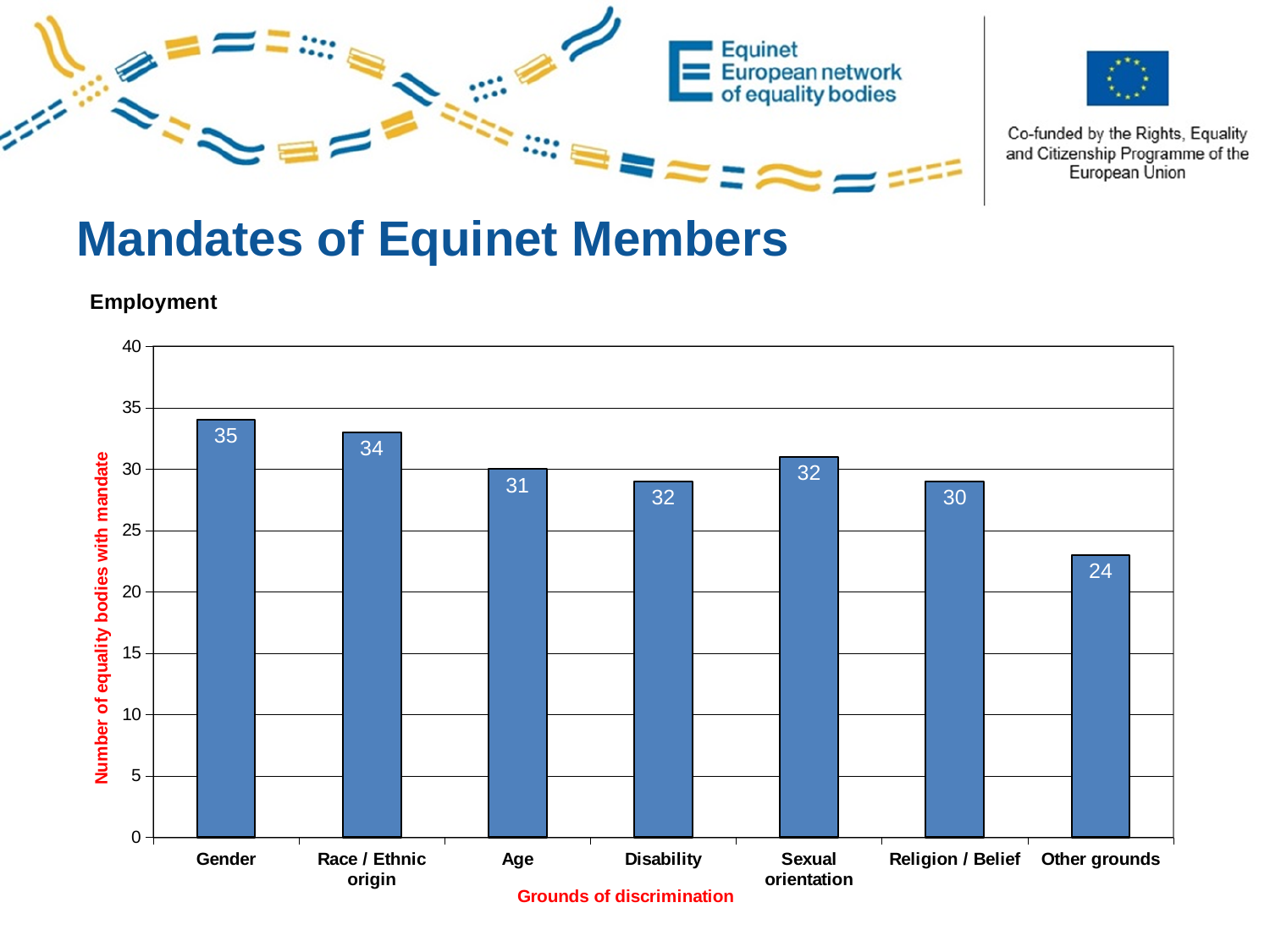
What is the value for Other grounds in the Employment chart? 24 What is the value for Gender in the Employment chart? 35 Which ground of discrimination has the highest number of equality bodies with mandate? Gender What is the label of the y axis of the chart? Number of equality bodies with mandate Which has a larger value, Age or Race / Ethnic origin? Race / Ethnic origin What is the difference between the values for Gender and Other grounds? 11 Which ground of discrimination has the lowest number of equality bodies with mandate? Other grounds What is the value for Race / Ethnic origin in the Employment chart? 34 How many grounds of discrimination are shown on the x axis? 7 Is the value for Other grounds greater or less than 25? less What is the value for Religion / Belief in the Employment chart? 30 What kind of chart is shown on the slide? bar chart